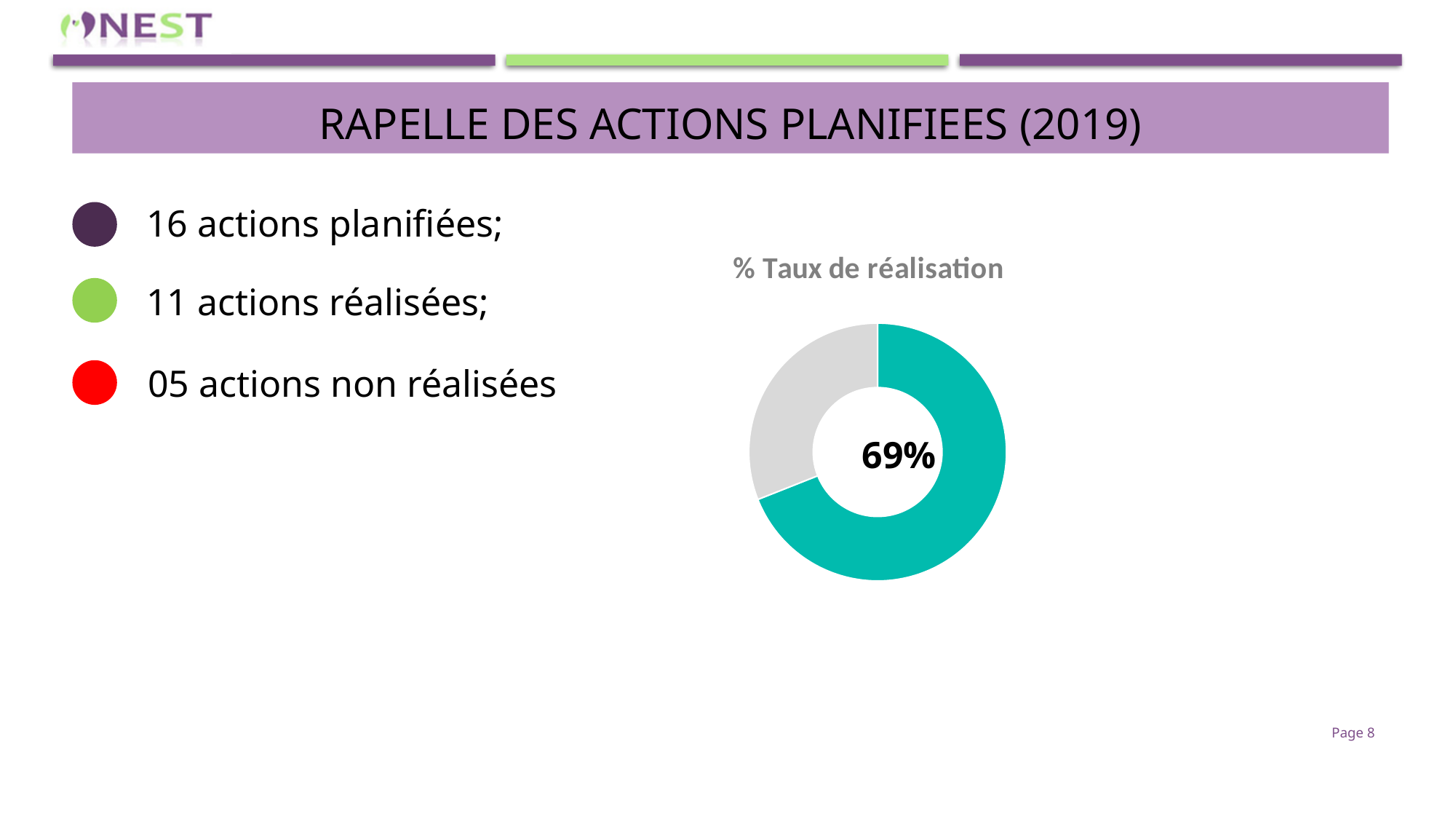
What percentage is printed in the centre of the doughnut chart? 69% What kind of chart is shown on the slide? doughnut chart What share of the doughnut does the teal segment represent? 69% What is the title of the chart? % Taux de réalisation Is the teal segment of the doughnut chart greater or less than 50%? greater How many segments does the doughnut chart have? 2 Which segment of the doughnut chart is larger, the teal one or the grey one? teal What colour is the larger segment of the doughnut chart? teal